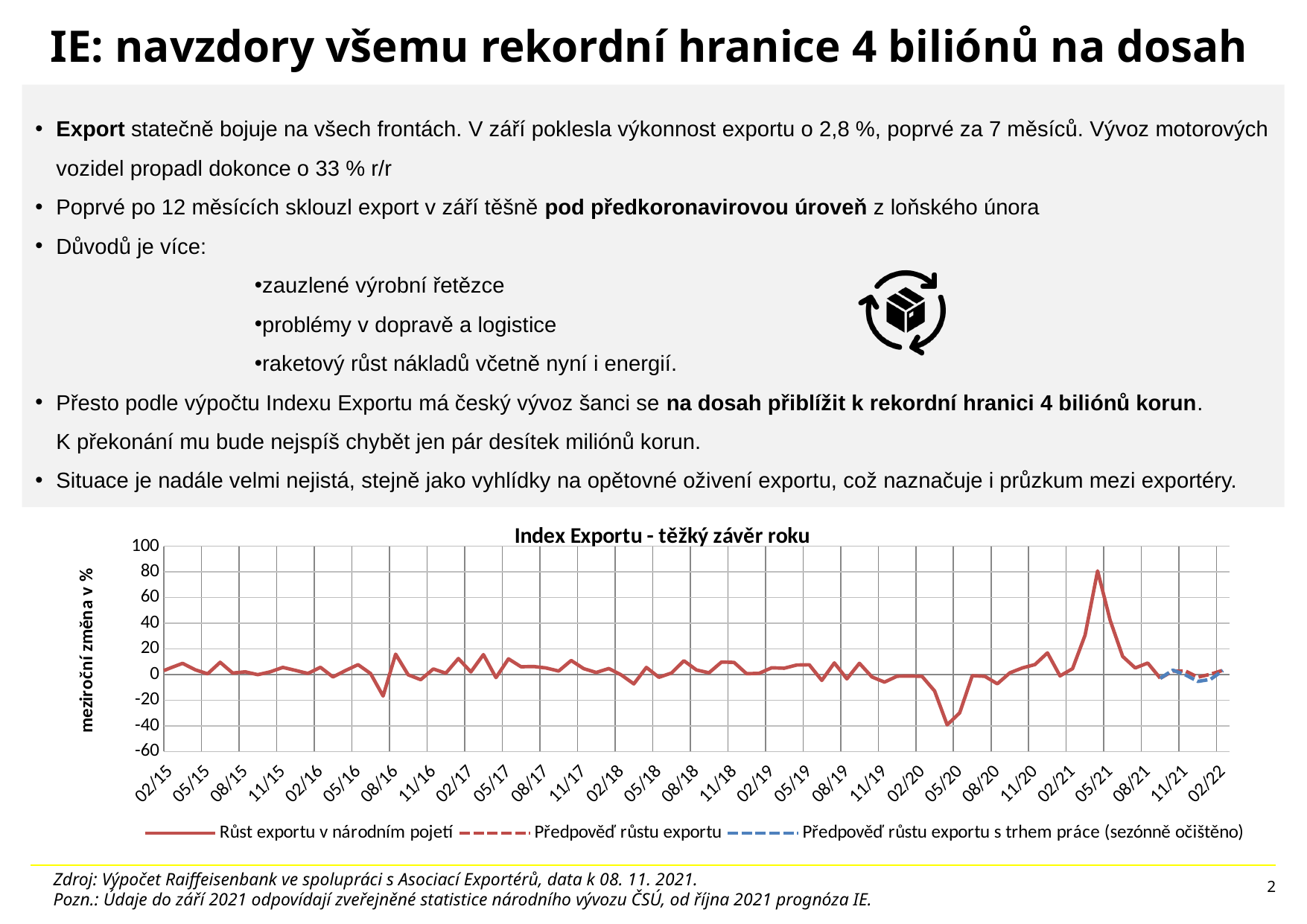
How many series does the chart legend list? 3 Is the lowest value of the 'Růst exportu v národním pojetí' series in spring 2020 greater or less than -20? less What is the lowest value shown on the vertical axis of the chart? -60 What is the first month label on the horizontal axis of the chart? 02/15 What is the label of the vertical axis of the chart? meziroční změna v % Is the peak value of the 'Růst exportu v národním pojetí' series in spring 2021 greater or less than 60? greater Which is larger: the value of 'Růst exportu v národním pojetí' around 05/21 or around 05/20? 05/21 Does the 'Růst exportu v národním pojetí' series rise or fall between 05/21 and 08/21? fall Is the value of 'Růst exportu v národním pojetí' around 08/16 greater or less than -10? less What kind of chart is shown on the slide? line chart